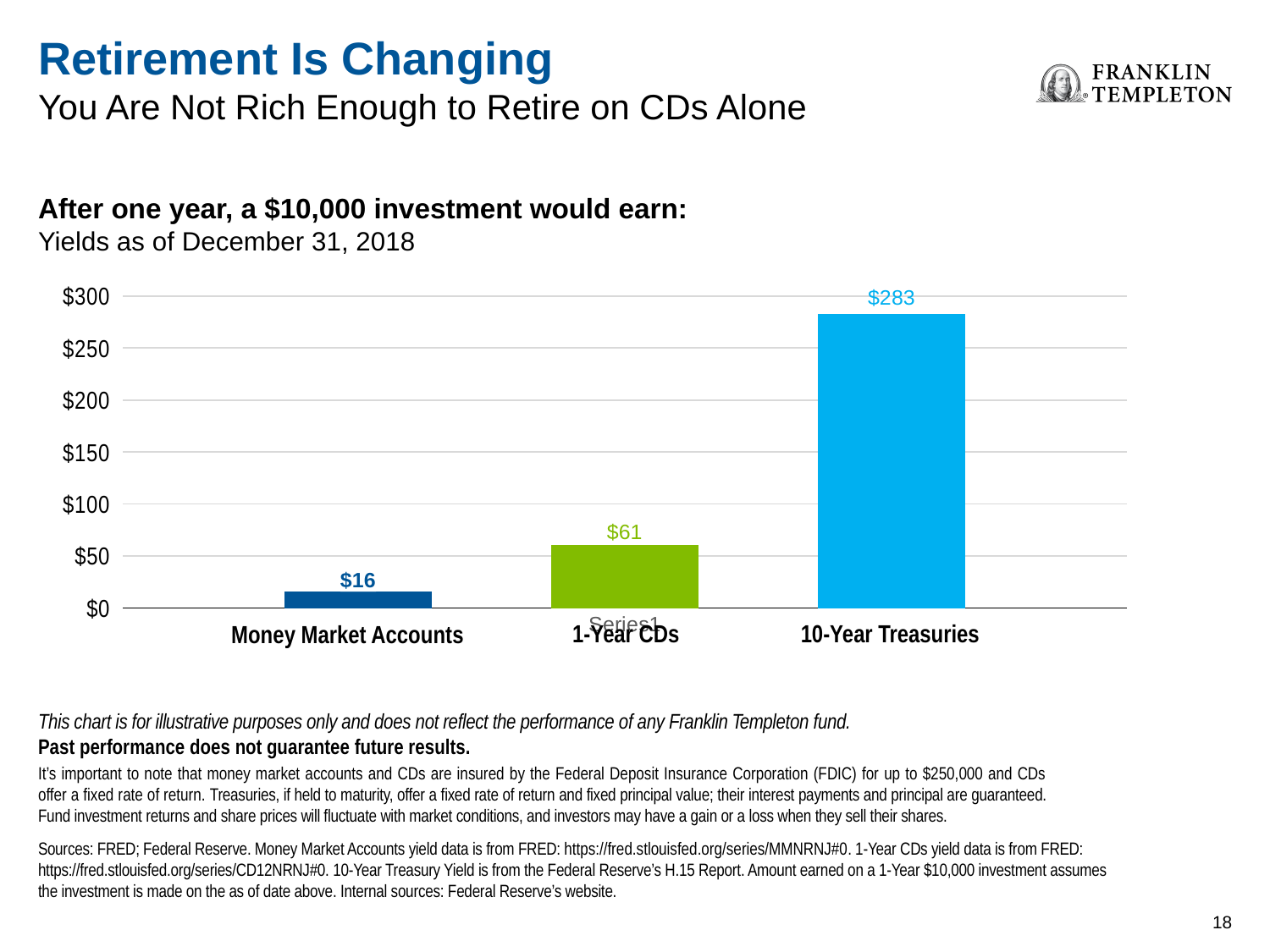
What is the difference between the earnings for 1-Year CDs and Money Market Accounts? $45 What amount would a $10,000 investment earn after one year in Money Market Accounts? $16 How much more would 10-Year Treasuries earn than 1-Year CDs? $222 Is the value for 10-Year Treasuries greater or less than $250? greater Which investment type earns the least after one year? Money Market Accounts What is the date of the yields used in the chart? December 31, 2018 What kind of chart is shown on the slide? Bar chart What amount would a $10,000 investment earn after one year in 1-Year CDs? $61 What amount would a $10,000 investment earn after one year in 10-Year Treasuries? $283 How many investment types are shown in the chart? 3 Which investment type earns the most after one year? 10-Year Treasuries Which earns more after one year, 1-Year CDs or Money Market Accounts? 1-Year CDs